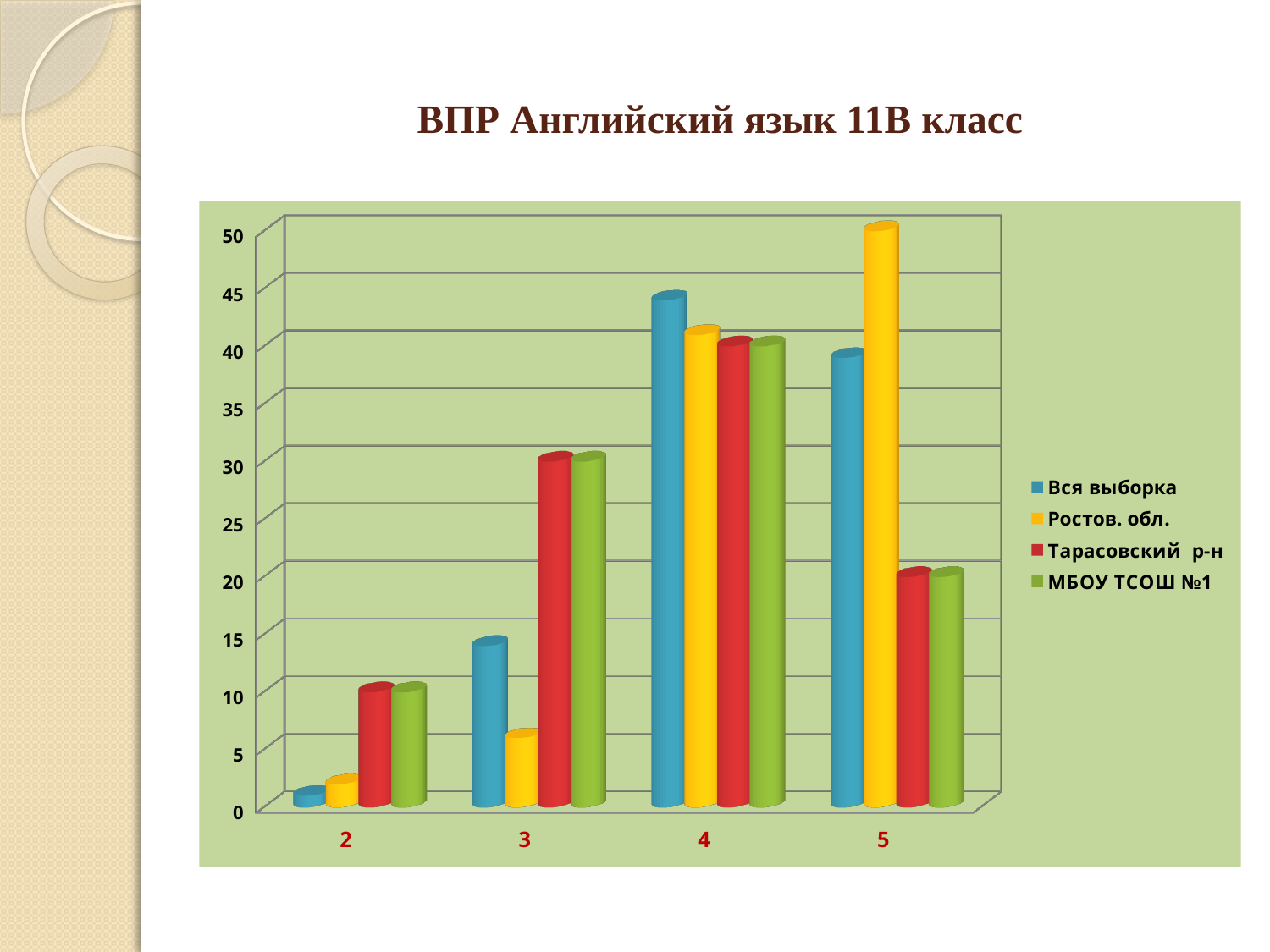
Is the value for Тарасовский р-н at category 5 greater or less than 25? less For the series Вся выборка, which category has the highest bar? 4 How many series does the legend list? 4 At category 3, which is larger: Вся выборка or Ростов. обл.? Вся выборка Is the value for Ростов. обл. at category 5 greater or less than 45? greater For the series Ростов. обл., which category has the highest bar? 5 For the series Вся выборка, which category has the lowest bar? 2 What kind of chart is shown on the slide? bar chart Which series is shown in yellow in the legend? Ростов. обл. At category 5, which is larger: Ростов. обл. or Вся выборка? Ростов. обл. How many categories are shown on the x axis? 4 What is the title of the chart? ВПР Английский язык 11В класс